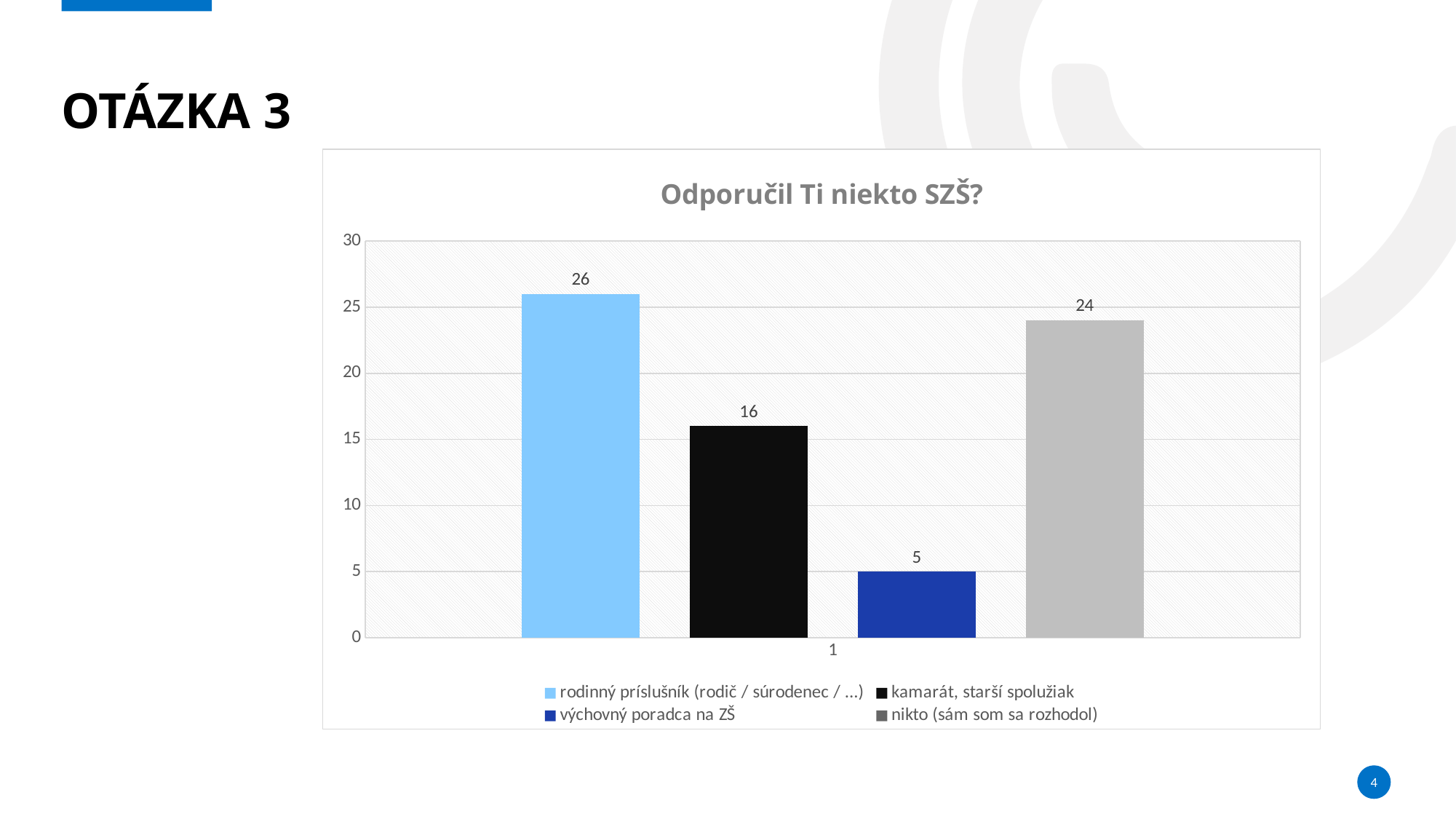
Which series has the lowest value? výchovný poradca na ZŠ What is the value for 'rodinný príslušník (rodič / súrodenec / ...)'? 26 Is the value for 'kamarát, starší spolužiak' greater or less than 20? less What is the value for 'výchovný poradca na ZŠ'? 5 What is the title of the chart? Odporučil Ti niekto SZŠ? What is the difference between the values for 'rodinný príslušník (rodič / súrodenec / ...)' and 'nikto (sám som sa rozhodol)'? 2 What kind of chart is shown on the slide? bar chart What is the value for 'nikto (sám som sa rozhodol)'? 24 Which series has the highest value? rodinný príslušník (rodič / súrodenec / ...) How many series does the legend list? 4 Which is larger: the value for 'kamarát, starší spolužiak' or the value for 'nikto (sám som sa rozhodol)'? nikto (sám som sa rozhodol) What is the value for 'kamarát, starší spolužiak'? 16